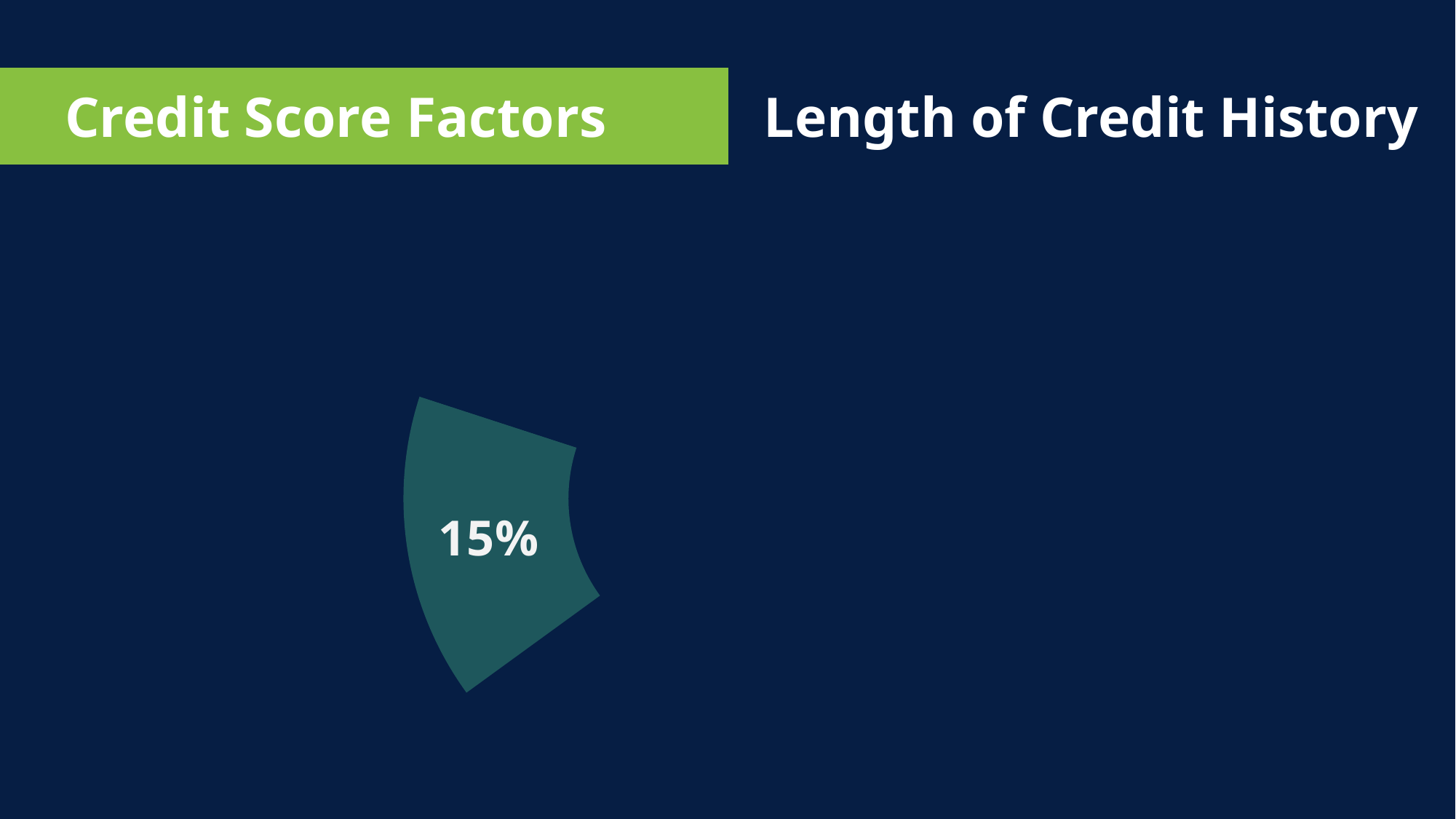
How many pie slices are visible on the slide? 1 What share of the pie does the Length of Credit History slice represent? 15% What percentage is shown on the pie slice for Length of Credit History? 15% What kind of chart is shown on the slide? doughnut chart Is the value shown on the pie slice greater or less than 20%? less Which credit score factor is the slide's chart about? Length of Credit History Is the value shown on the pie slice greater or less than 10%? greater What is the title shown in the green banner on the slide? Credit Score Factors